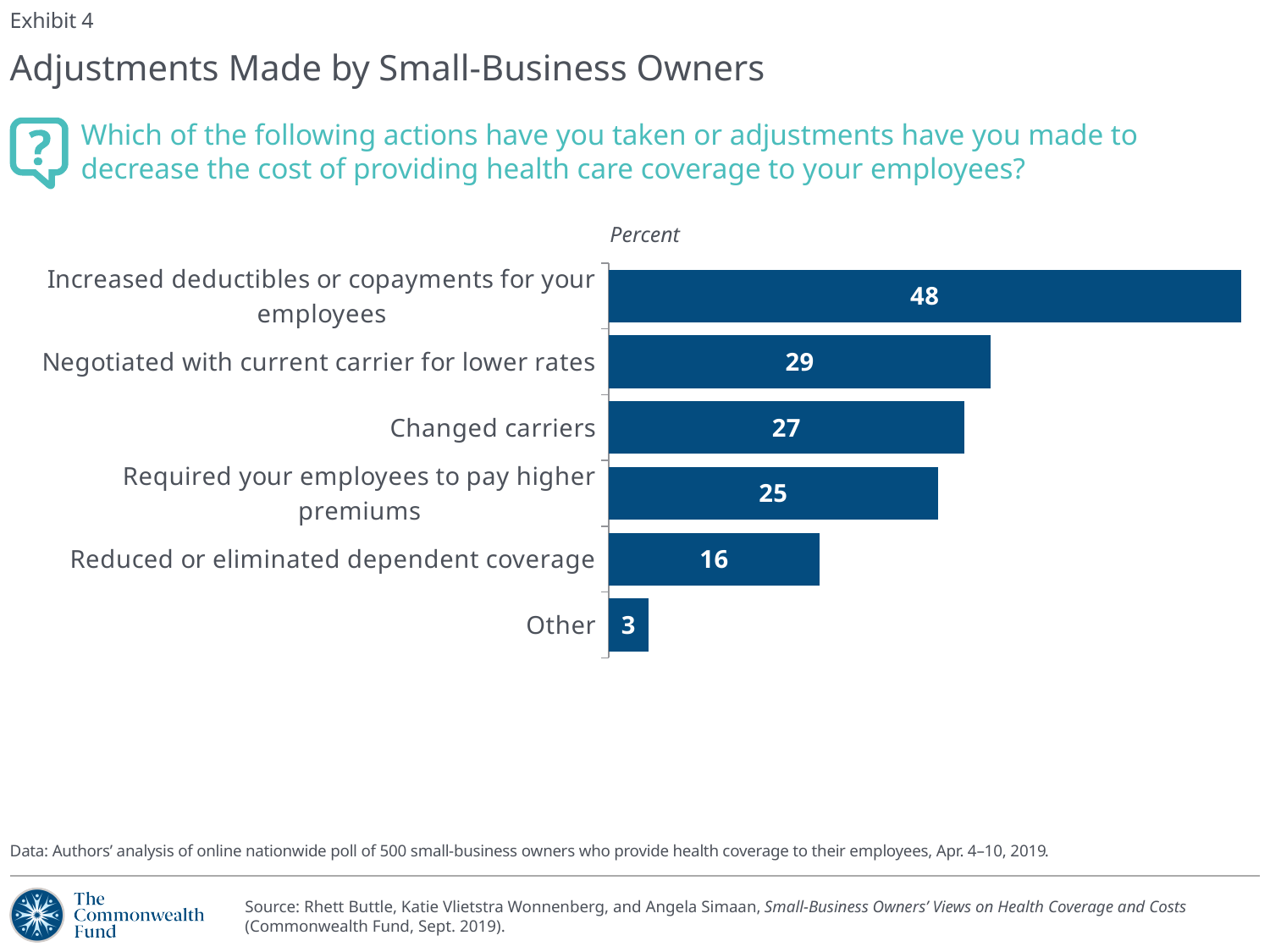
What is the difference between 'Increased deductibles or copayments for your employees' and 'Negotiated with current carrier for lower rates'? 19 Which adjustment has the highest percentage? Increased deductibles or copayments for your employees What kind of chart is shown on the slide? Bar chart What is the value for 'Changed carriers'? 27 What is the difference between 'Required your employees to pay higher premiums' and 'Reduced or eliminated dependent coverage'? 9 What is the value for 'Reduced or eliminated dependent coverage'? 16 Which is larger: 'Changed carriers' or 'Required your employees to pay higher premiums'? Changed carriers What is the value for 'Negotiated with current carrier for lower rates'? 29 What percentage of small-business owners increased deductibles or copayments for their employees? 48 Which category has the lowest value? Other What unit is indicated above the bars? Percent How many categories are shown in the chart? 6